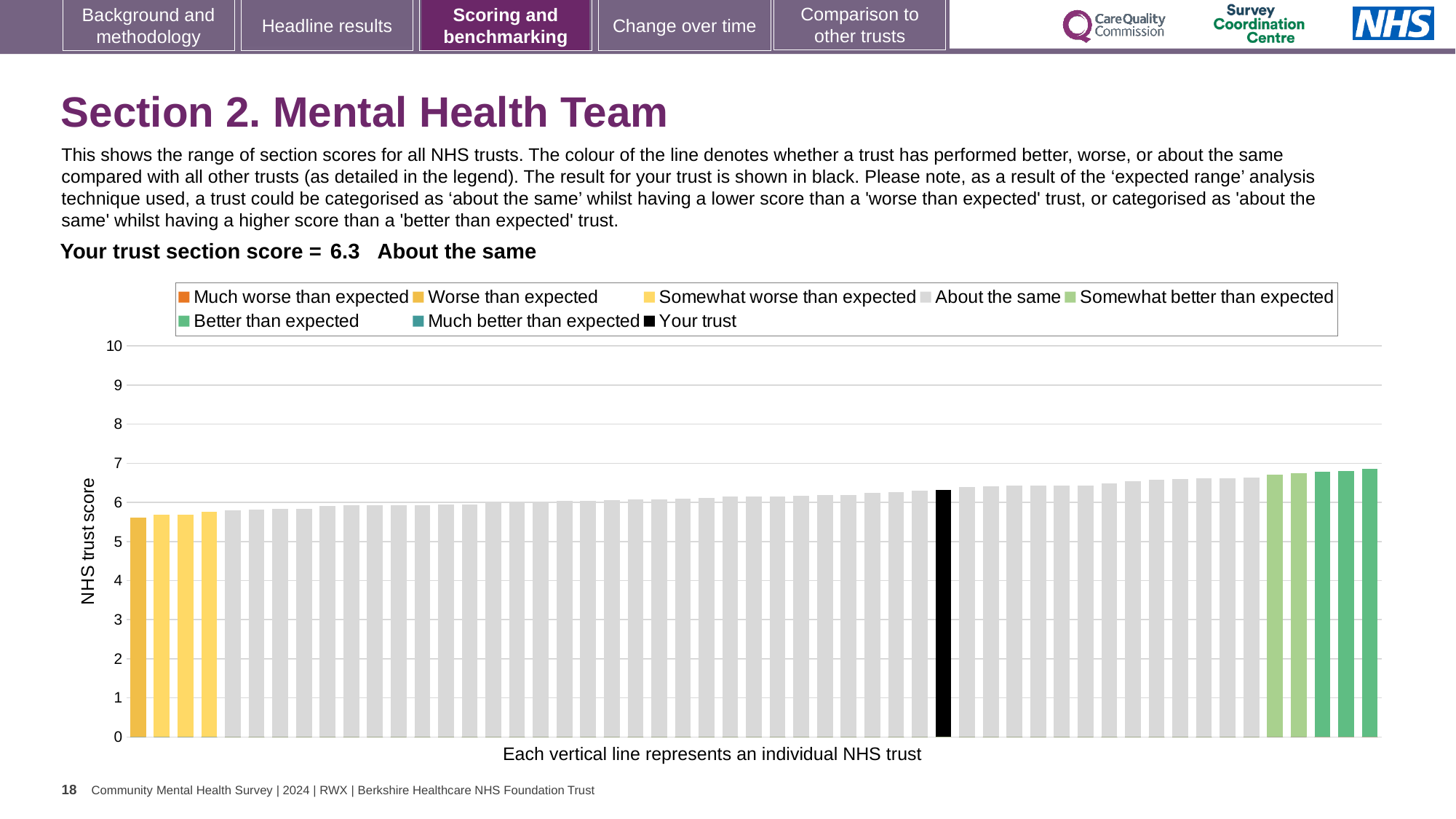
How many entries does the chart legend list? 8 Is the value of the highest bar in the chart greater or less than 7? less What is the highest value shown on the vertical axis? 10 What colour is the bar representing your trust? black Is the value for your trust (the black bar) greater or less than 6? greater Do the bar values rise or fall from left to right along the x axis? rise What is the section score for your trust shown on the slide? 6.3 What kind of chart is shown on the slide? bar chart What is the title of the vertical axis? NHS trust score Is the value for your trust (the black bar) greater or less than 7? less